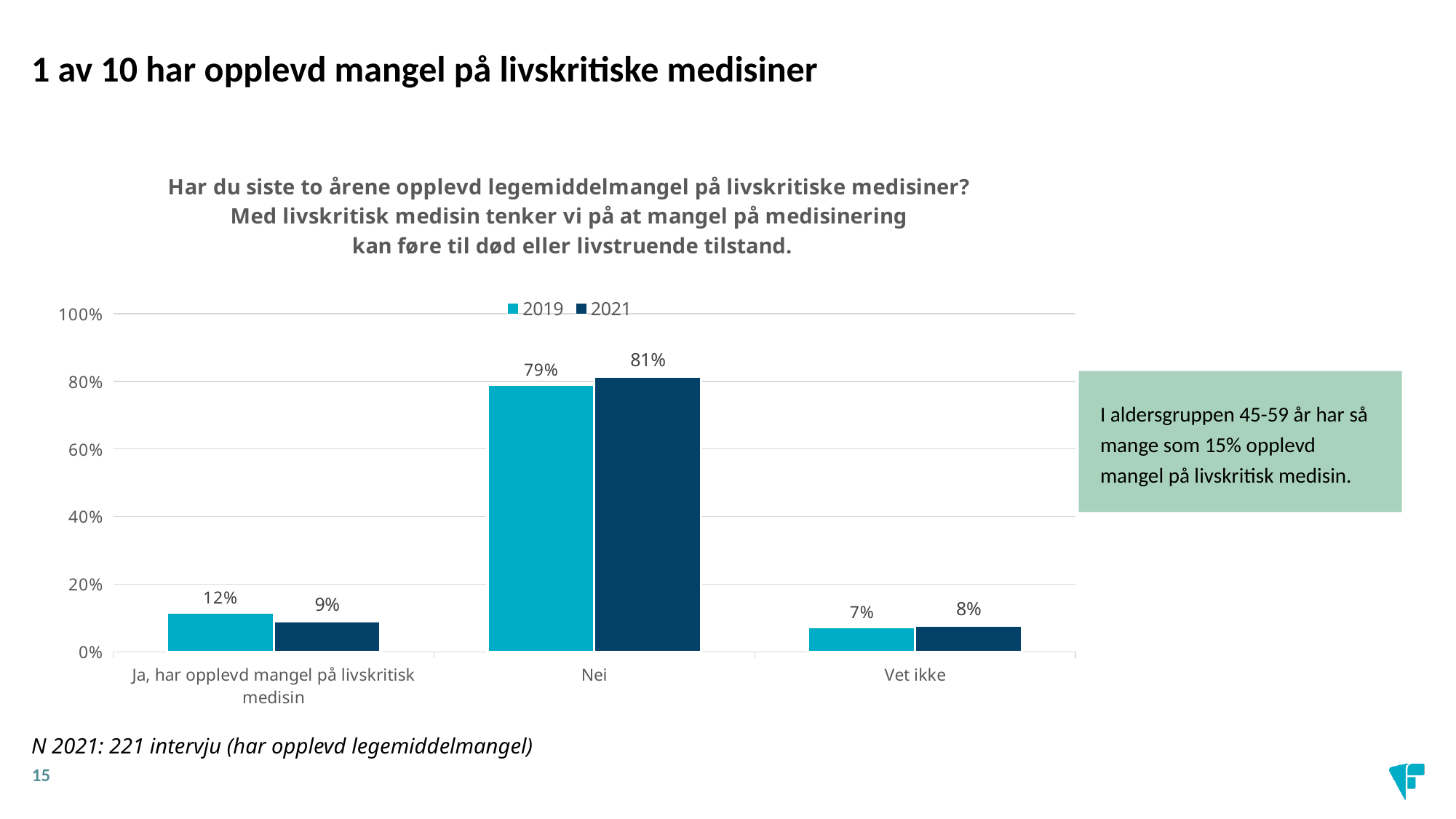
How many series does the legend list? 2 What is the 2019 value for "Vet ikke"? 7% What is the difference between the 2019 and 2021 values for "Ja, har opplevd mangel på livskritisk medisin"? 3% What kind of chart is shown on the slide? Bar chart Which category has the highest value in the 2021 series? Nei Which years are listed in the chart legend? 2019 and 2021 What is the 2019 value for "Ja, har opplevd mangel på livskritisk medisin"? 12% Which category has the lowest value in the 2019 series? Vet ikke Which is larger for "Nei": the 2019 value or the 2021 value? 2021 Is the 2021 value for "Nei" greater or less than 80%? greater How many categories are shown on the x axis? 3 What is the 2021 value for "Nei"? 81%